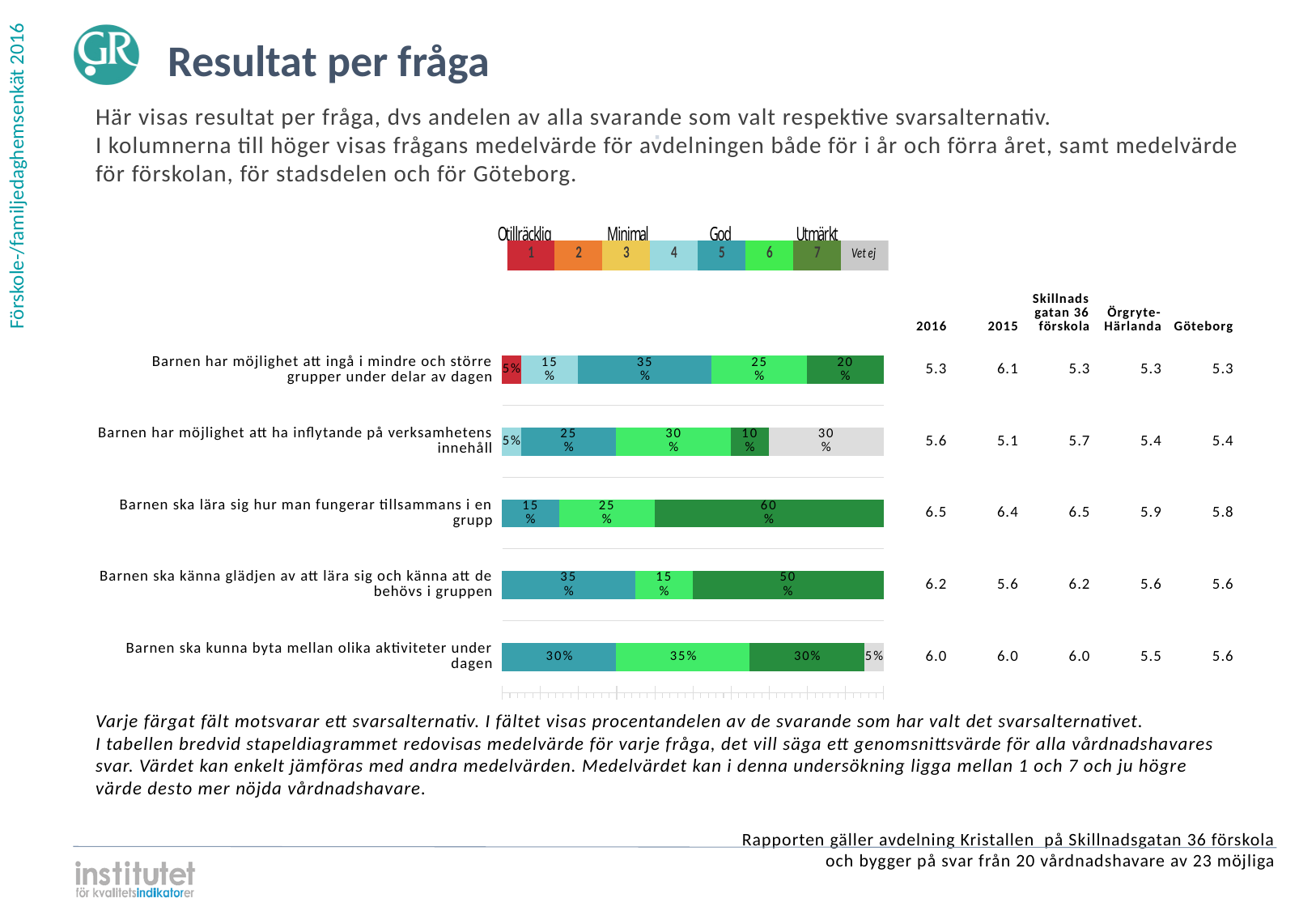
What is the Göteborg mean value for 'Barnen ska kunna byta mellan olika aktiviteter under dagen'? 5.6 What percentage chose 'Vet ej' for 'Barnen har möjlighet att ha inflytande på verksamhetens innehåll'? 30% What percentage of respondents chose option 7 (Utmärkt) for 'Barnen ska lära sig hur man fungerar tillsammans i en grupp'? 60% How many response options does the legend above the chart list? 8 What is the difference in the option 7 share between 'Barnen ska lära sig hur man fungerar tillsammans i en grupp' and 'Barnen ska känna glädjen av att lära sig och känna att de behövs i gruppen'? 10 percentage points What kind of chart is used to show the results per question? Stacked bar chart What percentage chose option 5 for 'Barnen ska känna glädjen av att lära sig och känna att de behövs i gruppen'? 35% For 'Barnen ska kunna byta mellan olika aktiviteter under dagen', which option has the larger share: option 6 or option 7? Option 6 How many questions (categories) are shown in the bar chart? 5 What percentage chose option 1 (Otillräcklig) for 'Barnen har möjlighet att ingå i mindre och större grupper under delar av dagen'? 5% What is the 2016 mean value for 'Barnen ska lära sig hur man fungerar tillsammans i en grupp'? 6.5 Which question has the largest share of respondents choosing option 7 (Utmärkt)? Barnen ska lära sig hur man fungerar tillsammans i en grupp